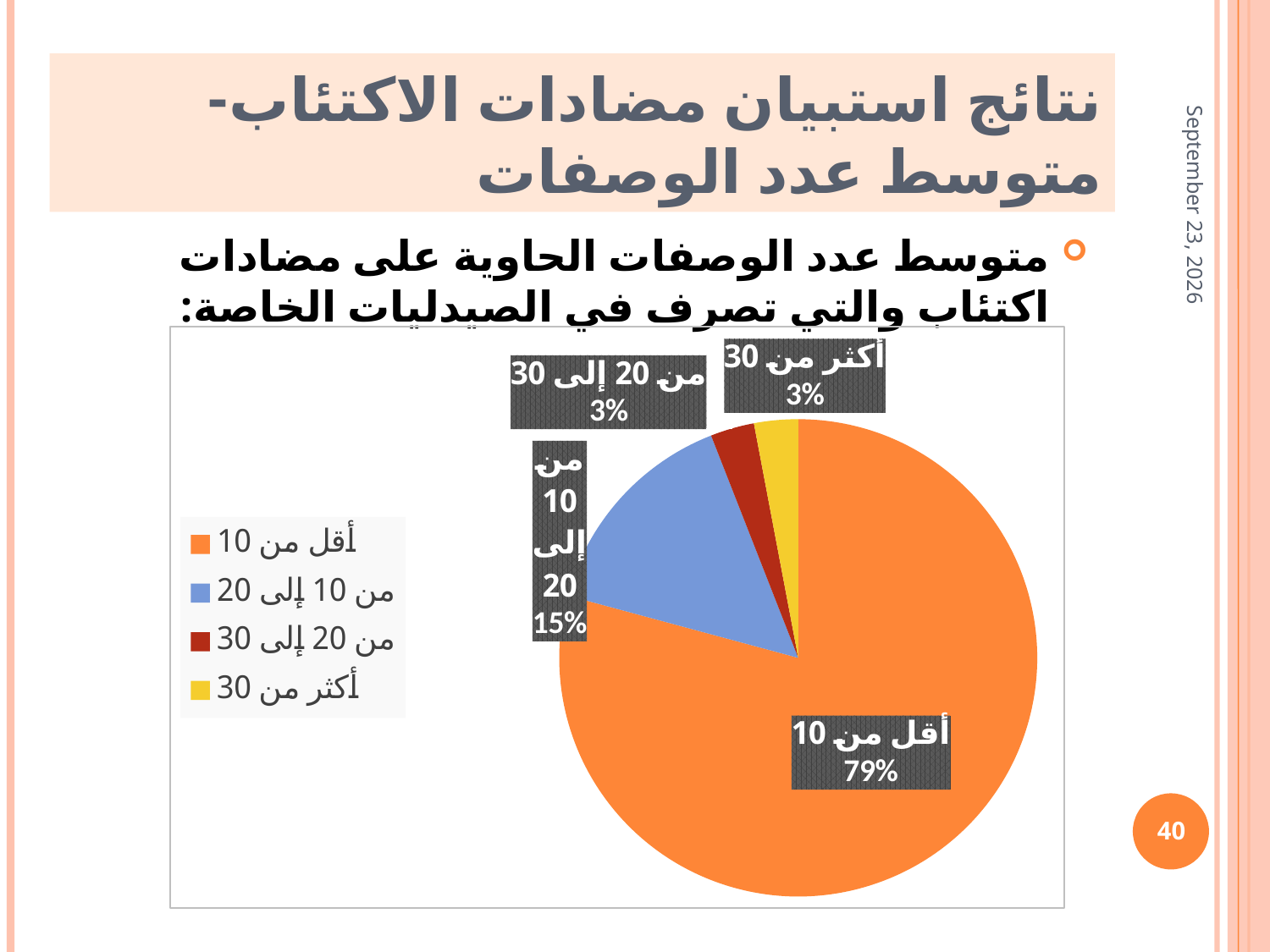
How many entries does the legend of the pie chart list? 4 What percentage is shown for the slice labelled أقل من 10? 79% Which category has the largest slice of the pie chart? أقل من 10 Which slice is larger: من 10 إلى 20 or من 20 إلى 30? من 10 إلى 20 What type of chart is shown on the slide? Pie chart What is the difference in percentage points between the أقل من 10 slice and the من 10 إلى 20 slice? 64 What percentage is shown for the slice labelled من 20 إلى 30? 3% What percentage is shown for the slice labelled من 10 إلى 20? 15% What share of the pie does the أقل من 10 slice represent? 79% How many categories (slices) does the pie chart have? 4 What colour is the slice for أكثر من 30 in the pie chart? Yellow What percentage is shown for the slice labelled أكثر من 30? 3%